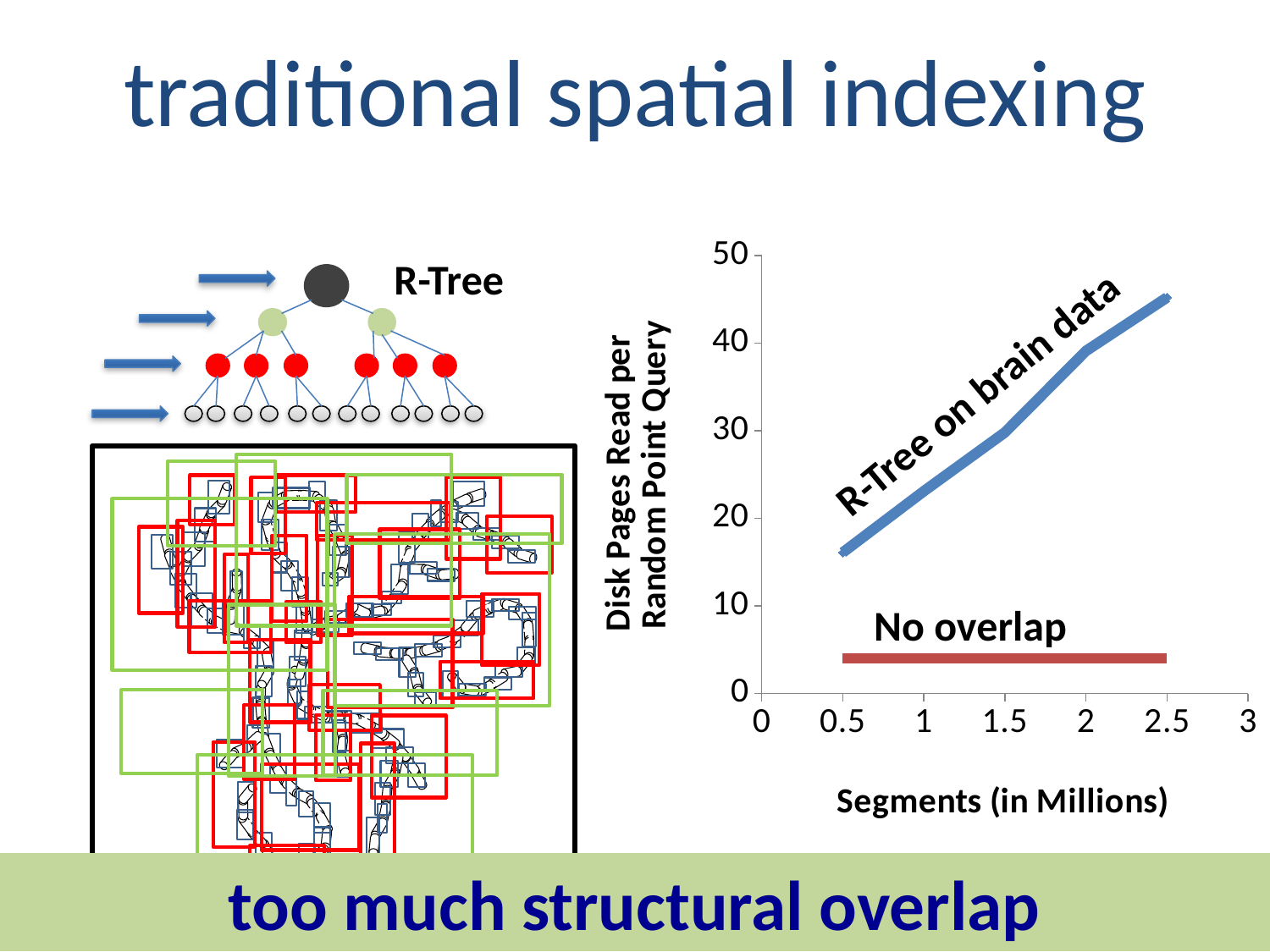
Which series has the higher value at 2.5 million segments, 'R-Tree on brain data' or 'No overlap'? R-Tree on brain data What is the title of the y axis of the chart? Disk Pages Read per Random Point Query Does the 'No overlap' line rise, fall, or stay flat as the number of segments increases? stay flat Which series has the lowest values across the chart? No overlap What kind of chart is shown on the right of the slide? line chart How many data series are plotted in the chart? 2 Does the 'R-Tree on brain data' line rise or fall as the number of segments increases? rise What is the title of the x axis of the chart? Segments (in Millions) What is the highest tick value shown on the y axis? 50 Is the value for 'R-Tree on brain data' at 2.5 million segments greater or less than 40? greater Is the value for 'No overlap' at 2.5 million segments greater or less than 10? less Is the value for 'R-Tree on brain data' at 0.5 million segments greater or less than 20? less